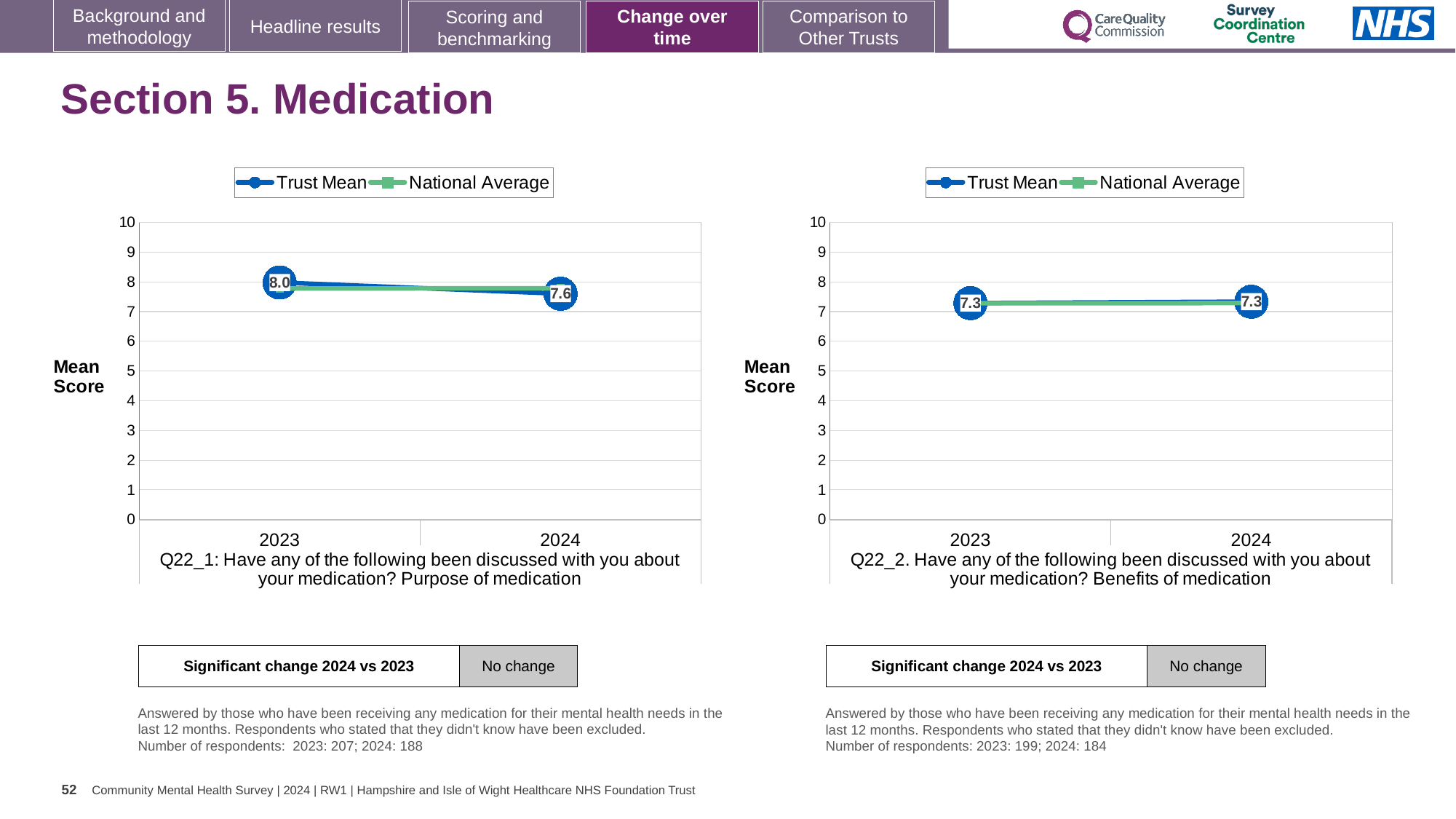
In the Q22_1 chart (left), by how much did the Trust Mean change from 2023 to 2024? 0.4 In the Q22_2 chart (right), does the Trust Mean rise, fall or stay the same from 2023 to 2024? stays the same What is the label on the y axis of the Q22_1 chart (left)? Mean Score How many series does the legend of the Q22_2 chart (right) list? 2 What kind of chart is the Q22_2 chart (right)? line chart In the Q22_2 chart (right), what is the Trust Mean for 2024? 7.3 In the Q22_1 chart (left), what is the Trust Mean for 2023? 8.0 In the Q22_1 chart (left), does the Trust Mean rise or fall from 2023 to 2024? fall How many years are plotted on the x axis of the Q22_1 chart (left)? 2 In the Q22_1 chart (left), which year has the higher Trust Mean, 2023 or 2024? 2023 In the Q22_1 chart (left), what is the Trust Mean for 2024? 7.6 In the Q22_2 chart (right), is the National Average for 2024 greater or less than 8? less